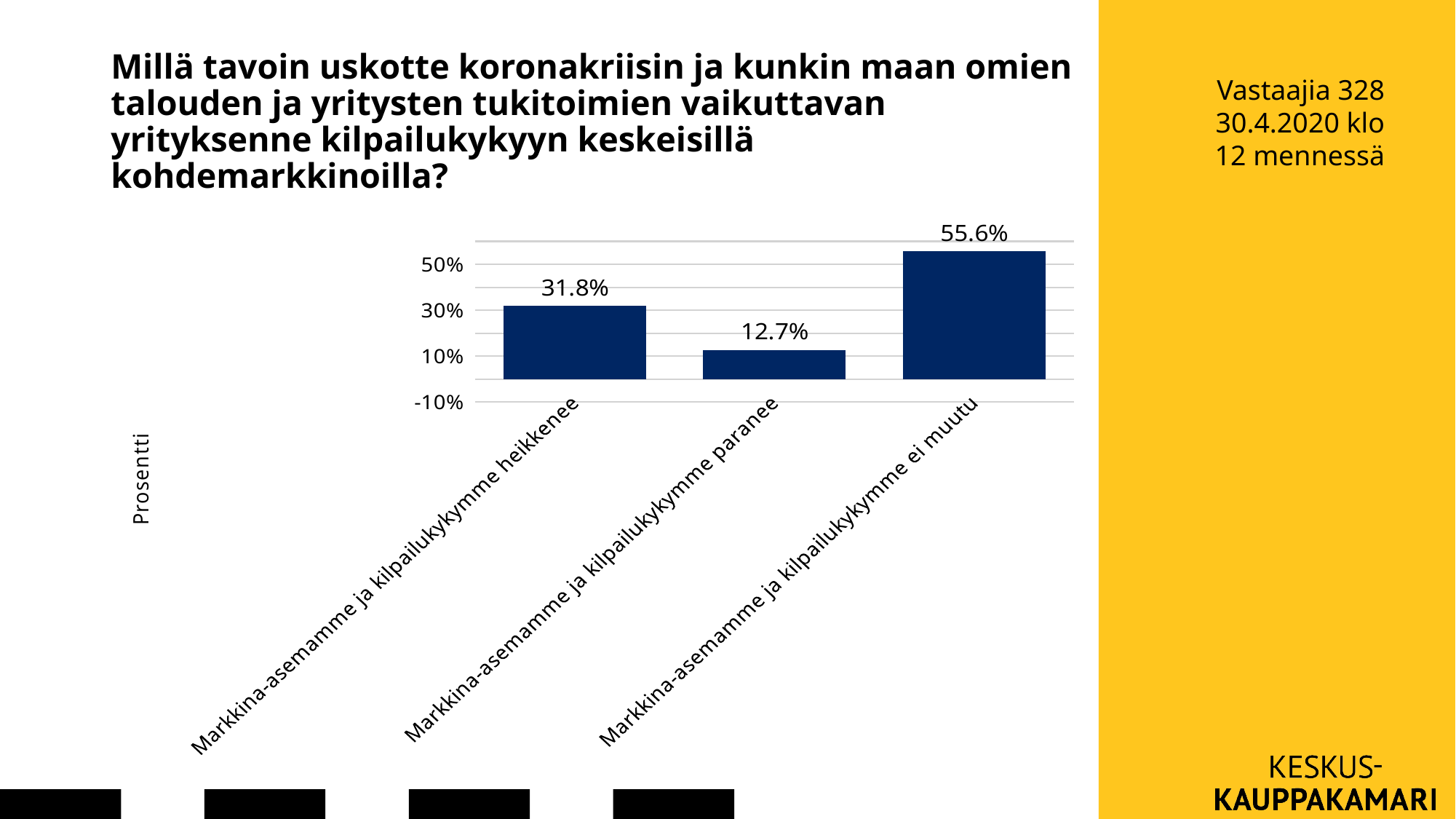
What is the difference between the values for "Markkina-asemamme ja kilpailukykymme ei muutu" and "Markkina-asemamme ja kilpailukykymme heikkenee"? 23.8% What is the value for "Markkina-asemamme ja kilpailukykymme ei muutu"? 55.6% Is the value for "Markkina-asemamme ja kilpailukykymme ei muutu" greater or less than 50%? greater What is the difference between the values for "Markkina-asemamme ja kilpailukykymme heikkenee" and "Markkina-asemamme ja kilpailukykymme paranee"? 19.1% What is the label of the vertical axis? Prosentti What is the value for "Markkina-asemamme ja kilpailukykymme heikkenee"? 31.8% How many categories are shown in the chart? 3 Which is larger, the value for "Markkina-asemamme ja kilpailukykymme heikkenee" or for "Markkina-asemamme ja kilpailukykymme paranee"? Markkina-asemamme ja kilpailukykymme heikkenee What kind of chart is shown on the slide? bar chart What is the value for "Markkina-asemamme ja kilpailukykymme paranee"? 12.7% Which category has the lowest value? Markkina-asemamme ja kilpailukykymme paranee Which category has the highest value? Markkina-asemamme ja kilpailukykymme ei muutu